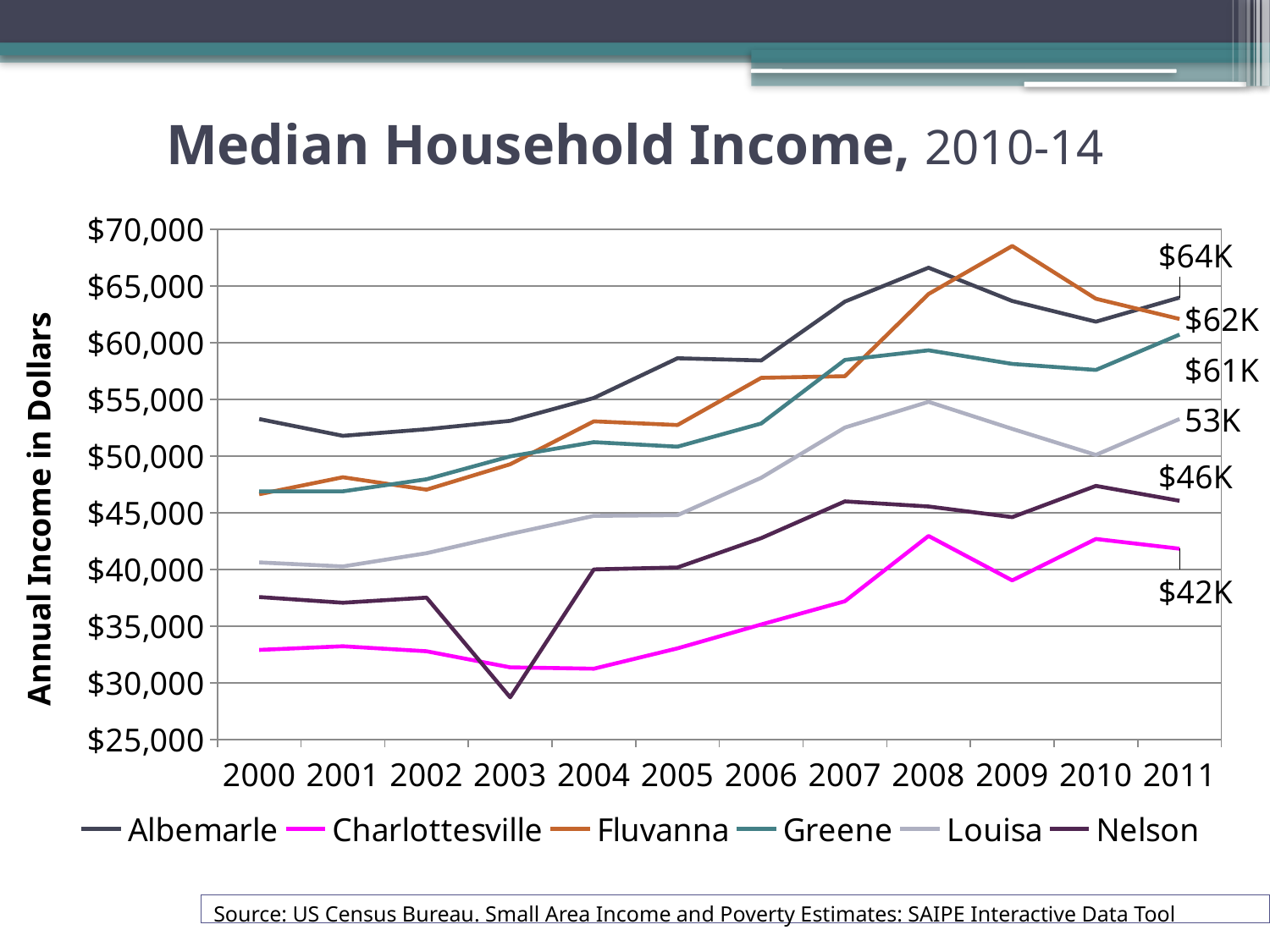
Is the value for Nelson in 2003 greater or less than $30,000? less What is the difference between the labelled 2011 values for Albemarle and Charlottesville? $22K How many series does the legend list? 6 Which is larger in 2011, the value for Greene or the value for Louisa? Greene What value is labelled for Louisa at the end of the line in 2011? 53K Is the value for Fluvanna in 2009 greater or less than $65,000? greater What value is labelled for Albemarle at the end of the line in 2011? $64K Which locality has the highest median household income in 2011? Albemarle How many years are shown along the x axis? 12 What kind of chart is shown on the slide? line chart Which locality has the lowest median household income in 2011? Charlottesville What value is labelled for Charlottesville at the end of the line in 2011? $42K